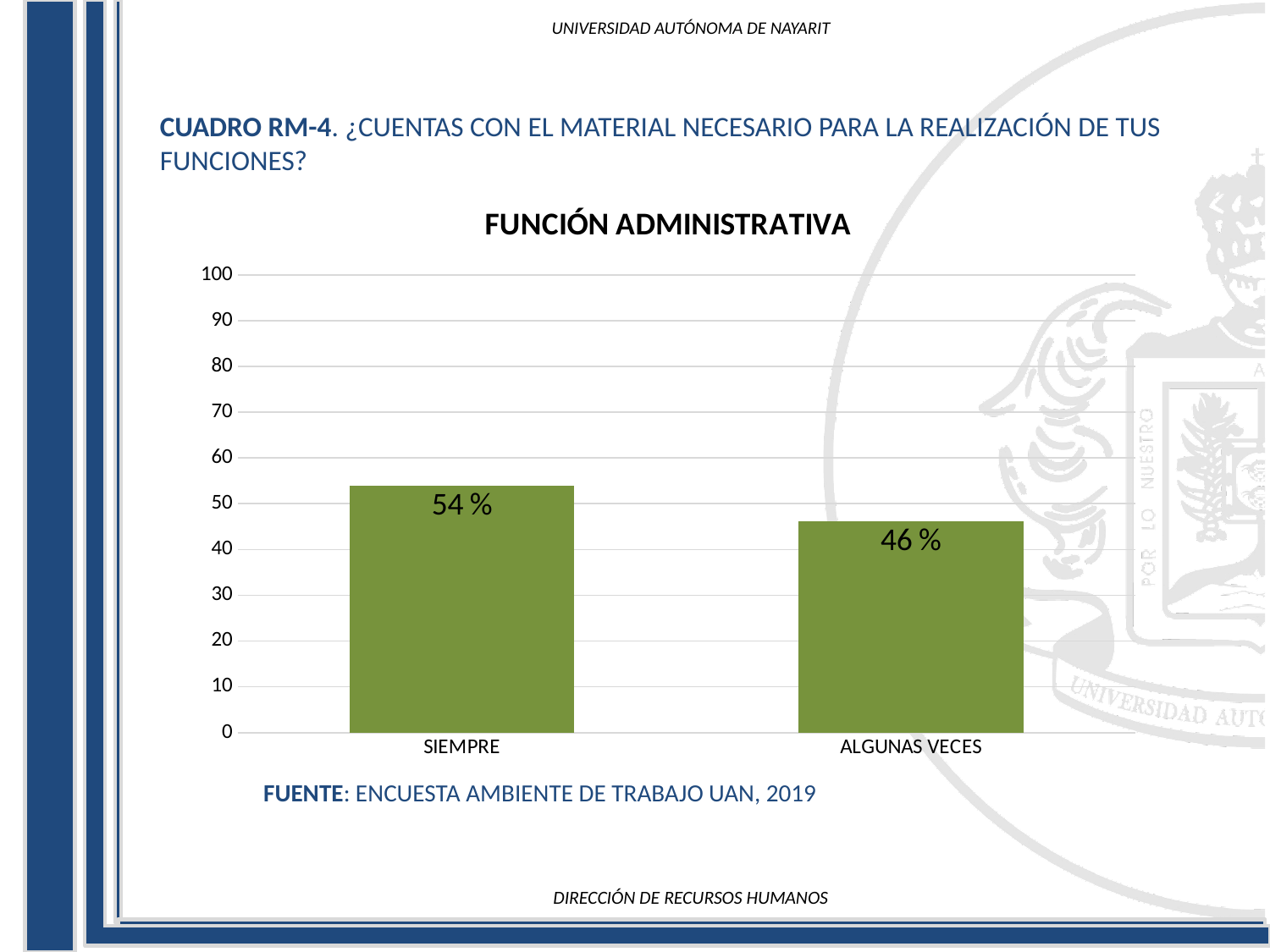
What is the difference between the values for SIEMPRE and ALGUNAS VECES? 8 % What kind of chart is shown on the slide? bar chart Which is larger, the value for SIEMPRE or the value for ALGUNAS VECES? SIEMPRE Which category has the highest value? SIEMPRE Which category has the lowest value? ALGUNAS VECES How many categories are shown on the chart? 2 What is the value for SIEMPRE? 54 % What is the value for ALGUNAS VECES? 46 % What is the highest value shown on the vertical axis? 100 What is the title of the chart? FUNCIÓN ADMINISTRATIVA Is the value for ALGUNAS VECES greater or less than 50? less Is the value for SIEMPRE greater or less than 50? greater